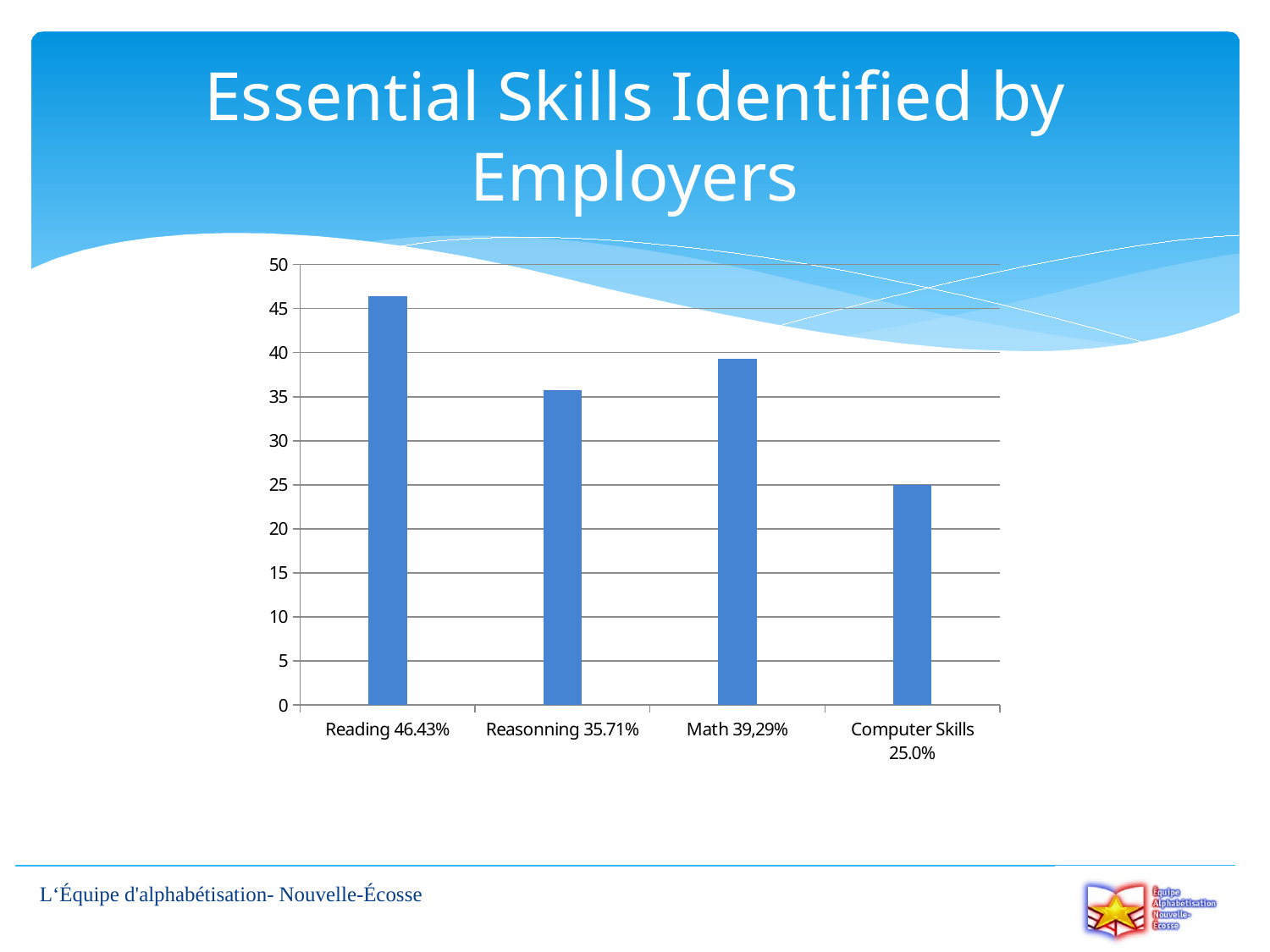
Which category has the highest bar? Reading 46.43% Is the value for Reasonning greater or less than 40? less What is the maximum value shown on the vertical axis? 50 Which is larger, the bar for Math or the bar for Reasonning? Math What percentage is printed in the category label for Reading? 46.43% What type of chart is shown on the slide? bar chart How many categories are shown in the chart? 4 Which category has the lowest bar? Computer Skills 25.0% Is the value for Reading greater or less than 45? greater What percentage is printed in the category label for Math? 39,29% What percentage is printed in the category label for Computer Skills? 25.0% What is the title of the slide containing the chart? Essential Skills Identified by Employers